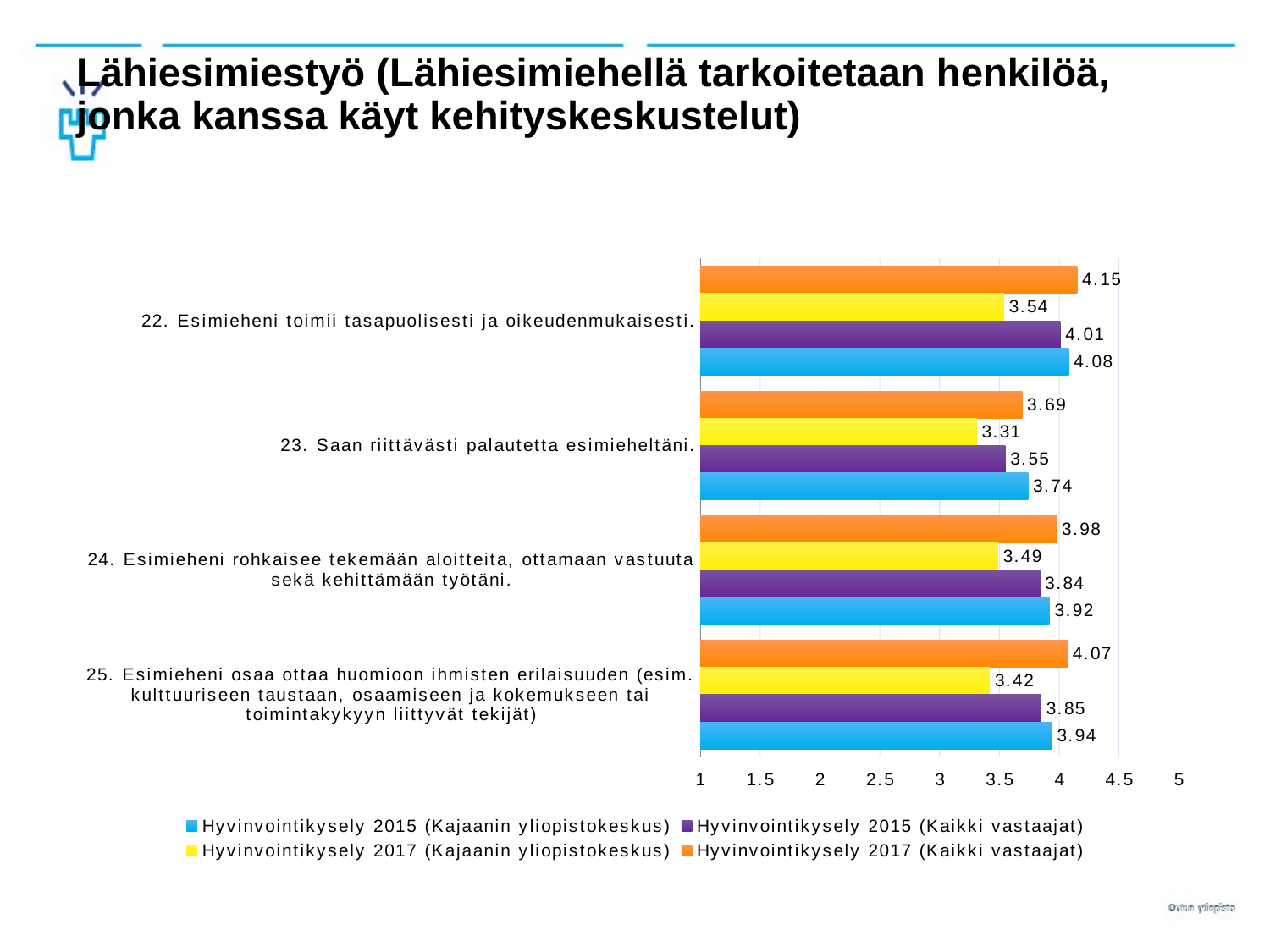
What is the value for Hyvinvointikysely 2015 (Kajaanin yliopistokeskus) for statement 25 (Esimieheni osaa ottaa huomioon ihmisten erilaisuuden)? 3.94 How many series does the legend list? 4 What is the value for Hyvinvointikysely 2017 (Kajaanin yliopistokeskus) for statement 23 (Saan riittävästi palautetta esimieheltäni)? 3.31 For statement 23, which is larger: the Hyvinvointikysely 2015 (Kajaanin yliopistokeskus) value or the Hyvinvointikysely 2015 (Kaikki vastaajat) value? Hyvinvointikysely 2015 (Kajaanin yliopistokeskus) Which statement has the highest value for Hyvinvointikysely 2017 (Kaikki vastaajat)? 22. Esimieheni toimii tasapuolisesti ja oikeudenmukaisesti. Which statement has the lowest value for Hyvinvointikysely 2017 (Kajaanin yliopistokeskus)? 23. Saan riittävästi palautetta esimieheltäni. What is the difference between the Hyvinvointikysely 2017 (Kaikki vastaajat) and Hyvinvointikysely 2017 (Kajaanin yliopistokeskus) values for statement 25? 0.65 Which colour represents Hyvinvointikysely 2017 (Kaikki vastaajat) in the legend? orange What is the value for Hyvinvointikysely 2017 (Kaikki vastaajat) for statement 22 (Esimieheni toimii tasapuolisesti ja oikeudenmukaisesti)? 4.15 What kind of chart is shown on the slide? bar chart What is the value for Hyvinvointikysely 2015 (Kaikki vastaajat) for statement 24 (Esimieheni rohkaisee tekemään aloitteita)? 3.84 How many categories (statements) are plotted on the chart? 4